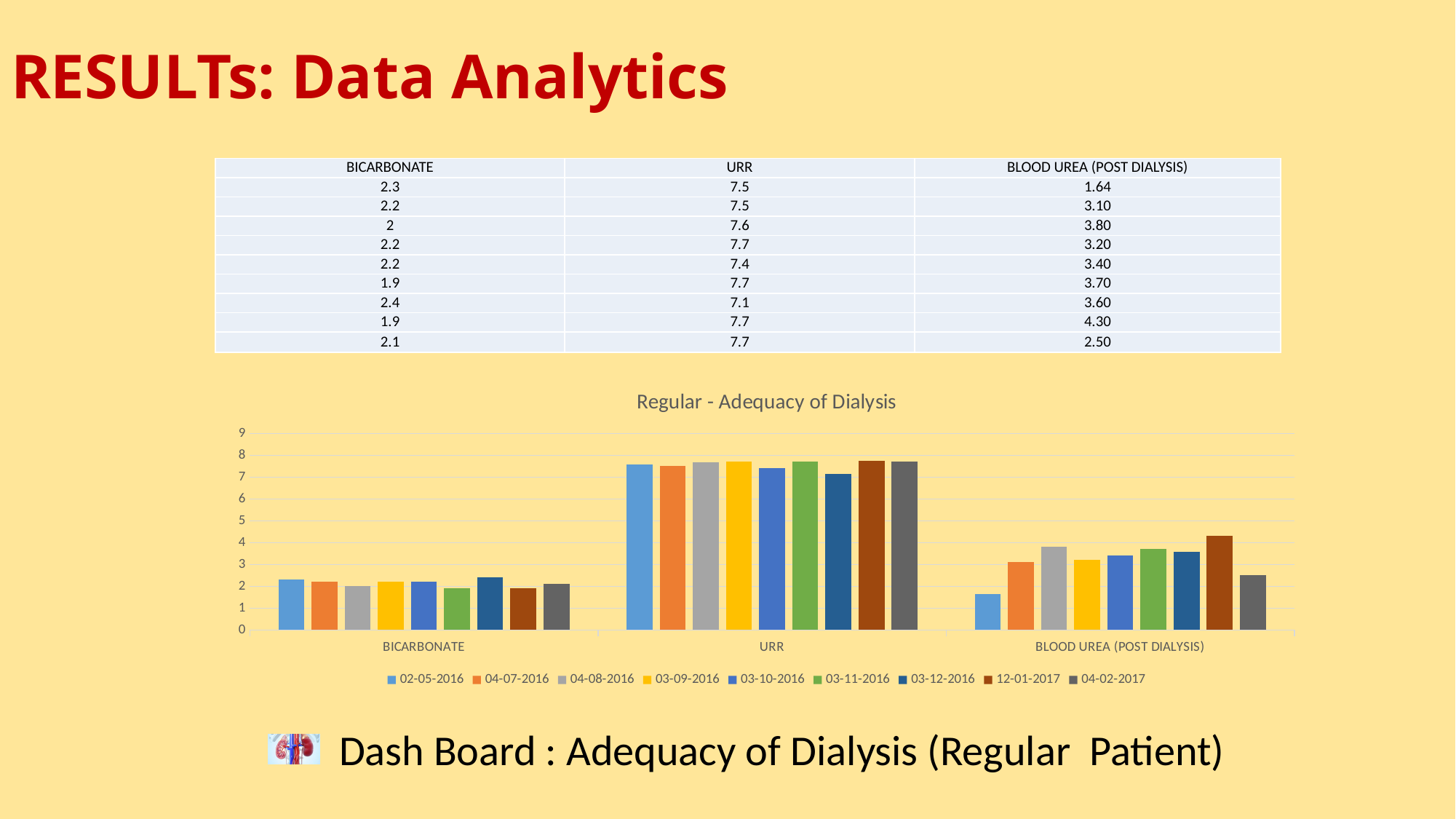
Which series has the highest bar in the BLOOD UREA (POST DIALYSIS) category? 12-01-2017 Is the BLOOD UREA (POST DIALYSIS) value for 12-01-2017 greater or less than 4? greater How many series does the chart legend list? 9 Which series has the lowest bar in the URR category? 03-12-2016 How many categories are shown on the x axis of the chart? 3 Is the BLOOD UREA (POST DIALYSIS) value for 02-05-2016 greater or less than 2? less Which category on the x axis has the tallest bars overall? URR What is the title of the chart? Regular - Adequacy of Dialysis Which series has the lowest bar in the BLOOD UREA (POST DIALYSIS) category? 02-05-2016 In the BLOOD UREA (POST DIALYSIS) category, which is larger: the bar for 04-08-2016 or the bar for 03-09-2016? 04-08-2016 Is the URR value for 02-05-2016 greater or less than 7? greater What kind of chart is shown on the slide? bar chart